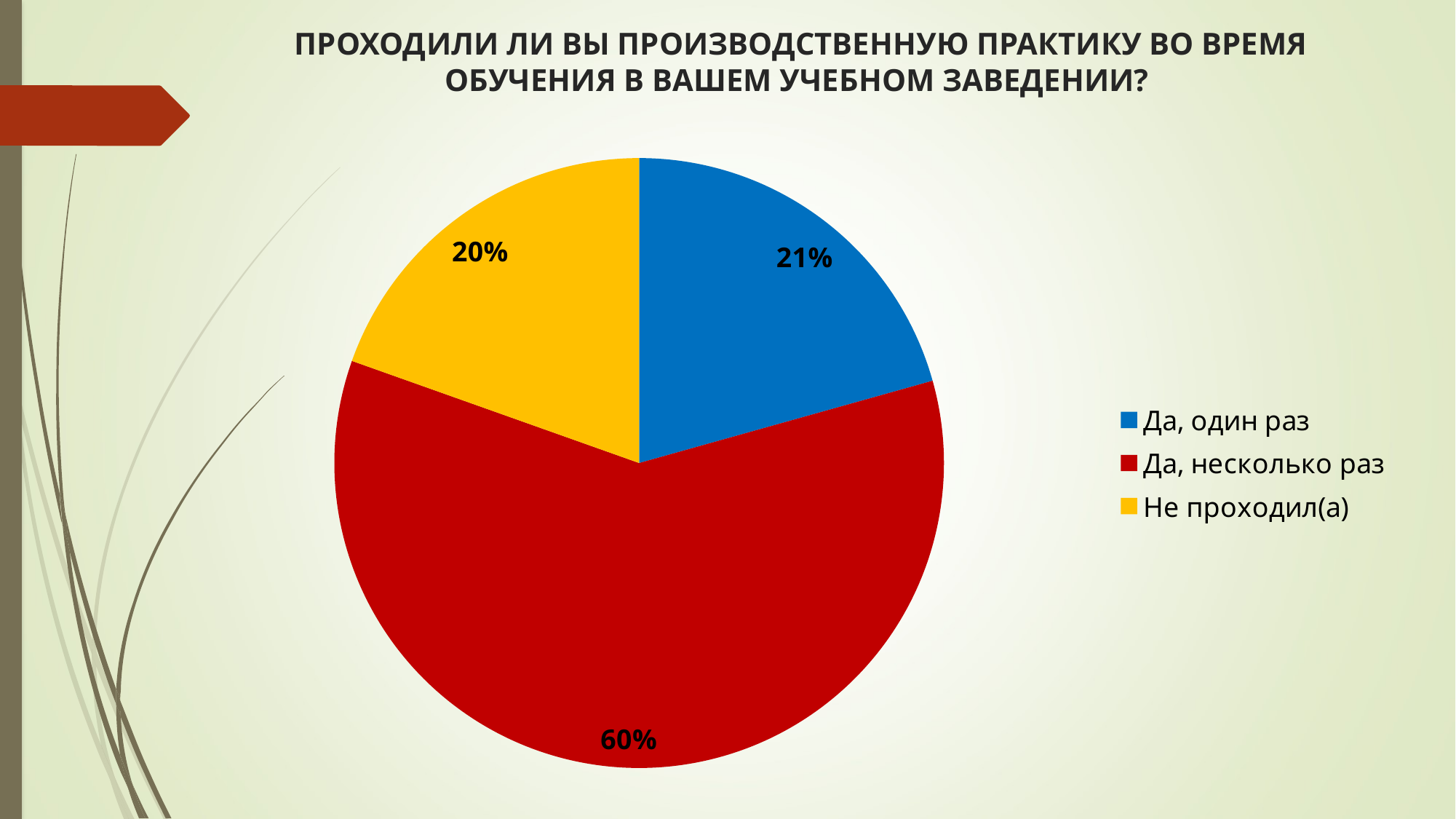
Which is larger: the share for "Да, несколько раз" or the share for "Не проходил(а)"? Да, несколько раз How many entries does the legend list? 3 How many slices does the pie chart have? 3 What is the title of the chart? ПРОХОДИЛИ ЛИ ВЫ ПРОИЗВОДСТВЕННУЮ ПРАКТИКУ ВО ВРЕМЯ ОБУЧЕНИЯ В ВАШЕМ УЧЕБНОМ ЗАВЕДЕНИИ? What is the difference in percentage points between "Да, несколько раз" and "Да, один раз"? 39 Which answer option has the largest share of the pie? Да, несколько раз What percentage of respondents answered "Не проходил(а)"? 20% What percentage of respondents answered "Да, один раз"? 21% What percentage of respondents answered "Да, несколько раз"? 60% Which answer option has the smallest share of the pie? Не проходил(а) What colour is the slice for "Да, один раз"? blue What kind of chart is shown on the slide? pie chart